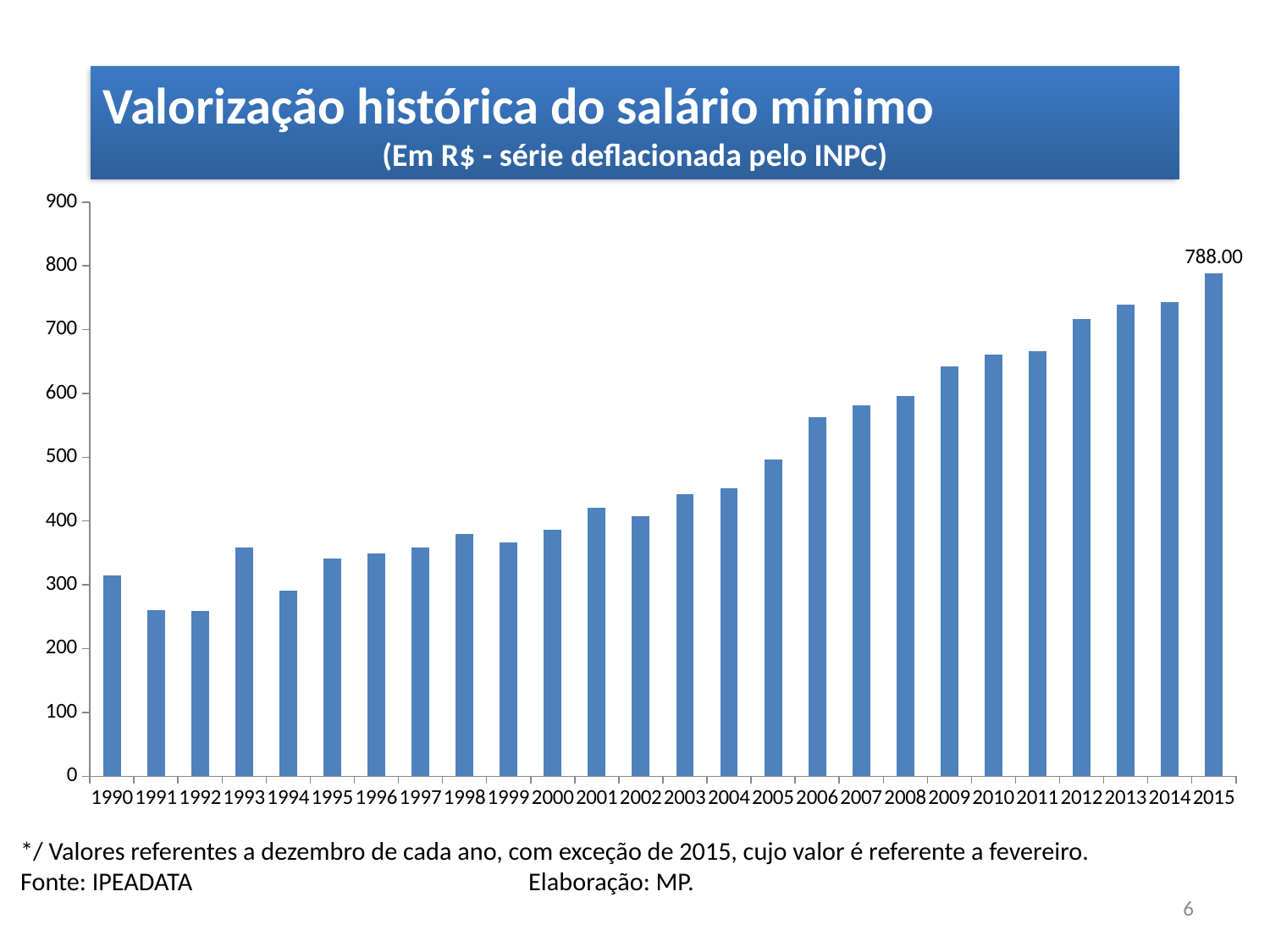
Is the value for 2006 greater or less than 500? greater Which is larger, the value for 2000 or the value for 2010? 2010 Is the value for 1994 greater or less than 400? less Is the value for 1990 greater or less than 300? greater Which year has the highest value? 2015 What is the title of the chart? Valorização histórica do salário mínimo How many years are plotted on the chart? 26 What kind of chart is shown on the slide? Bar chart What is the value shown for 2015? 788.00 Which is larger, the value for 1993 or the value for 1994? 1993 Do the values generally rise or fall from 1990 to 2015? Rise